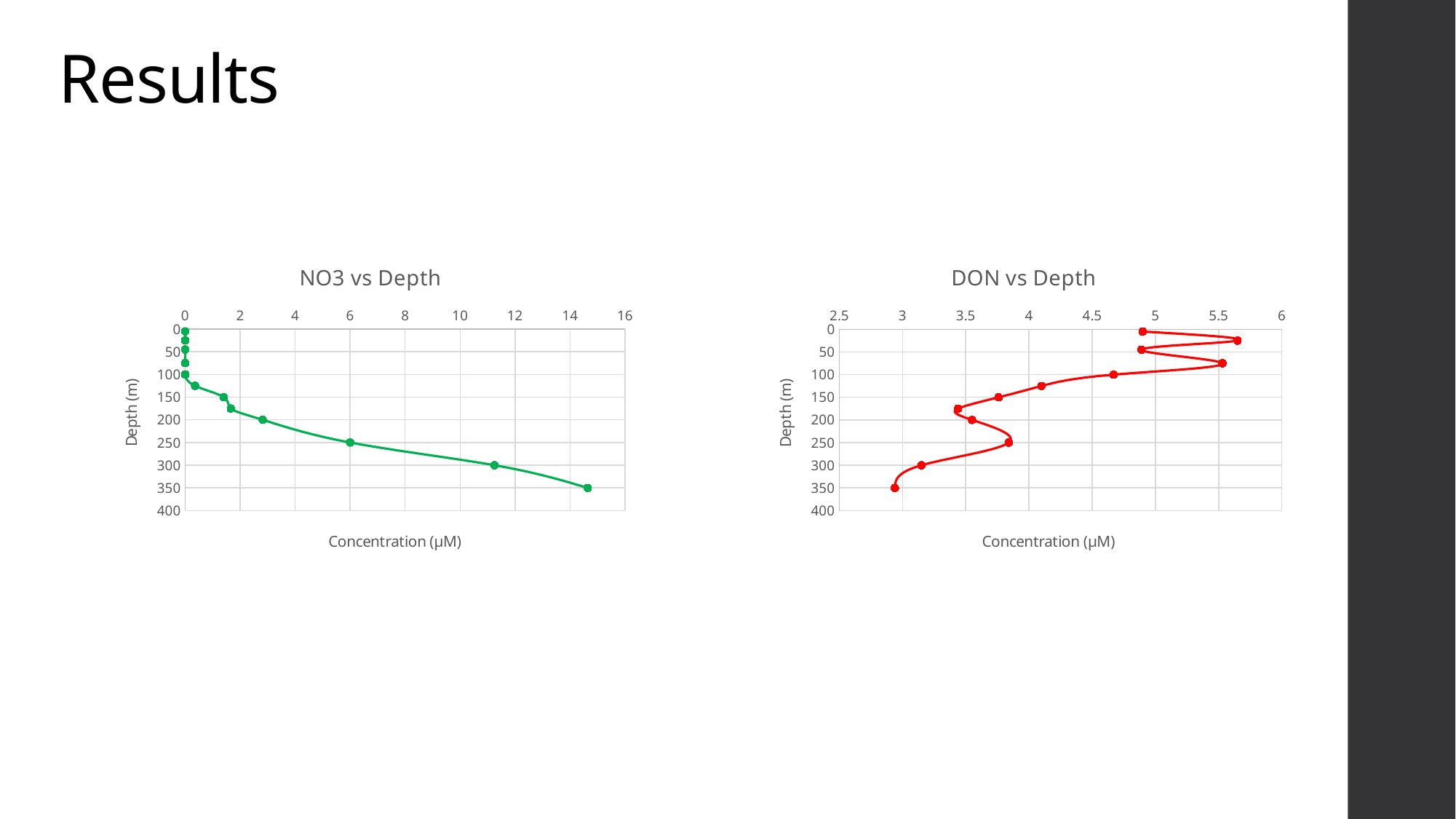
In the DON vs Depth chart, is the DON concentration at 250 m greater or less than 4 µM? less In the NO3 vs Depth chart, at which depth is the NO3 concentration highest? 350 m In the DON vs Depth chart, is the DON concentration at 25 m greater or less than 5.5 µM? greater In the NO3 vs Depth chart, is the NO3 concentration at 300 m greater or less than 10 µM? greater In the DON vs Depth chart, how many data points are plotted? 12 What is the x-axis label of the NO3 vs Depth chart? Concentration (µM) What kind of chart is the DON vs Depth chart? line chart In the DON vs Depth chart, at which depth is the DON concentration lowest? 350 m In the NO3 vs Depth chart, does NO3 concentration generally increase or decrease as depth increases? increase